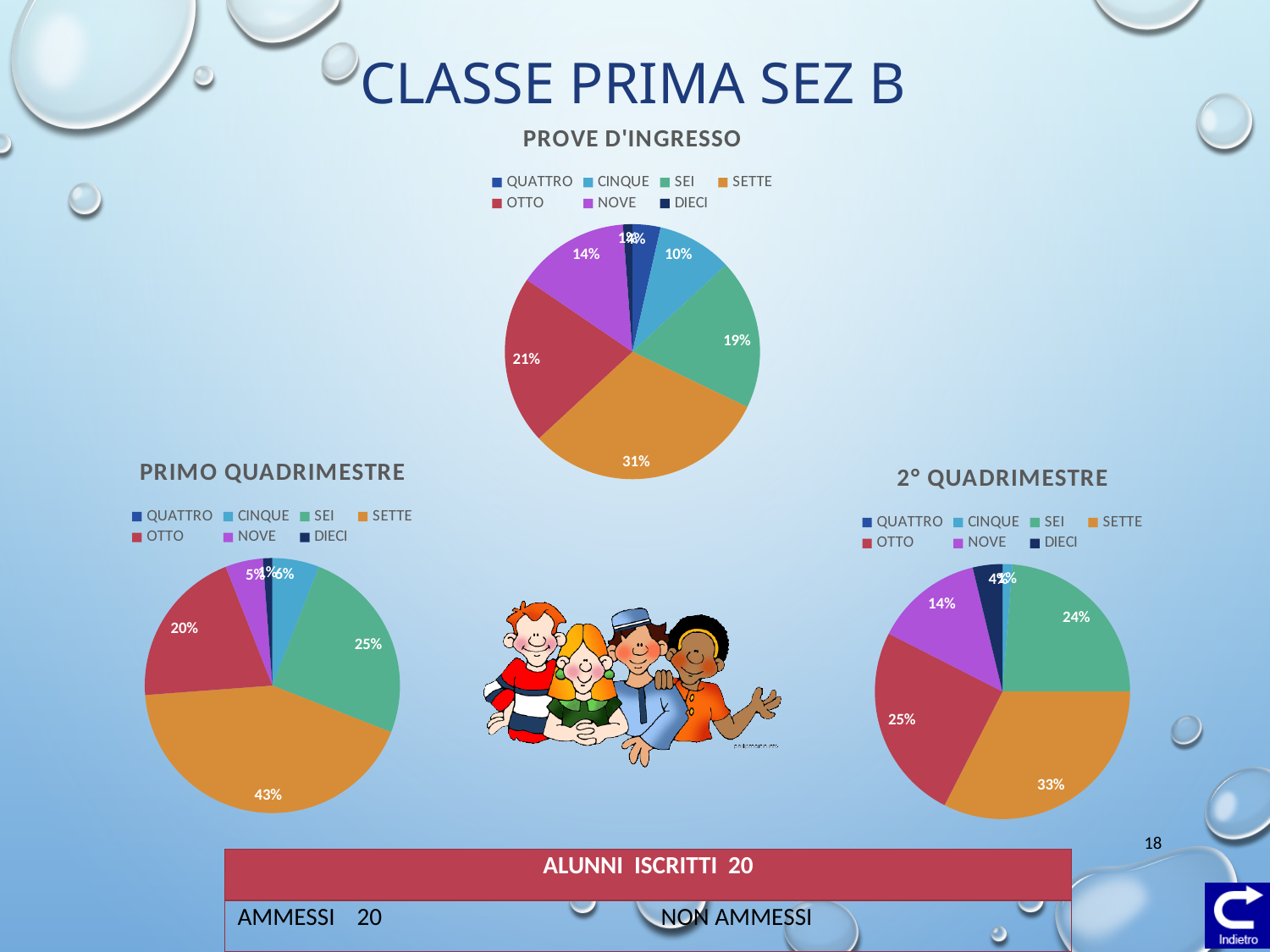
In the PROVE D'INGRESSO pie chart, what is the difference between the SEI and CINQUE percentages? 9% How many entries does the legend of the PRIMO QUADRIMESTRE chart list? 7 In the PRIMO QUADRIMESTRE pie chart, what percentage is shown for SEI? 25% In the PRIMO QUADRIMESTRE pie chart, what percentage is shown for SETTE? 43% In the PROVE D'INGRESSO pie chart, what percentage is shown for OTTO? 21% In the 2° QUADRIMESTRE pie chart, what percentage is shown for NOVE? 14% In the 2° QUADRIMESTRE pie chart, which category has the largest slice? SETTE In the PROVE D'INGRESSO pie chart, what percentage is shown for SETTE? 31% In the PROVE D'INGRESSO pie chart, which category has the largest slice? SETTE In the 2° QUADRIMESTRE pie chart, what percentage is shown for SETTE? 33% What type of chart is used for PROVE D'INGRESSO? Pie chart In the PRIMO QUADRIMESTRE pie chart, which is larger, OTTO or SEI? SEI